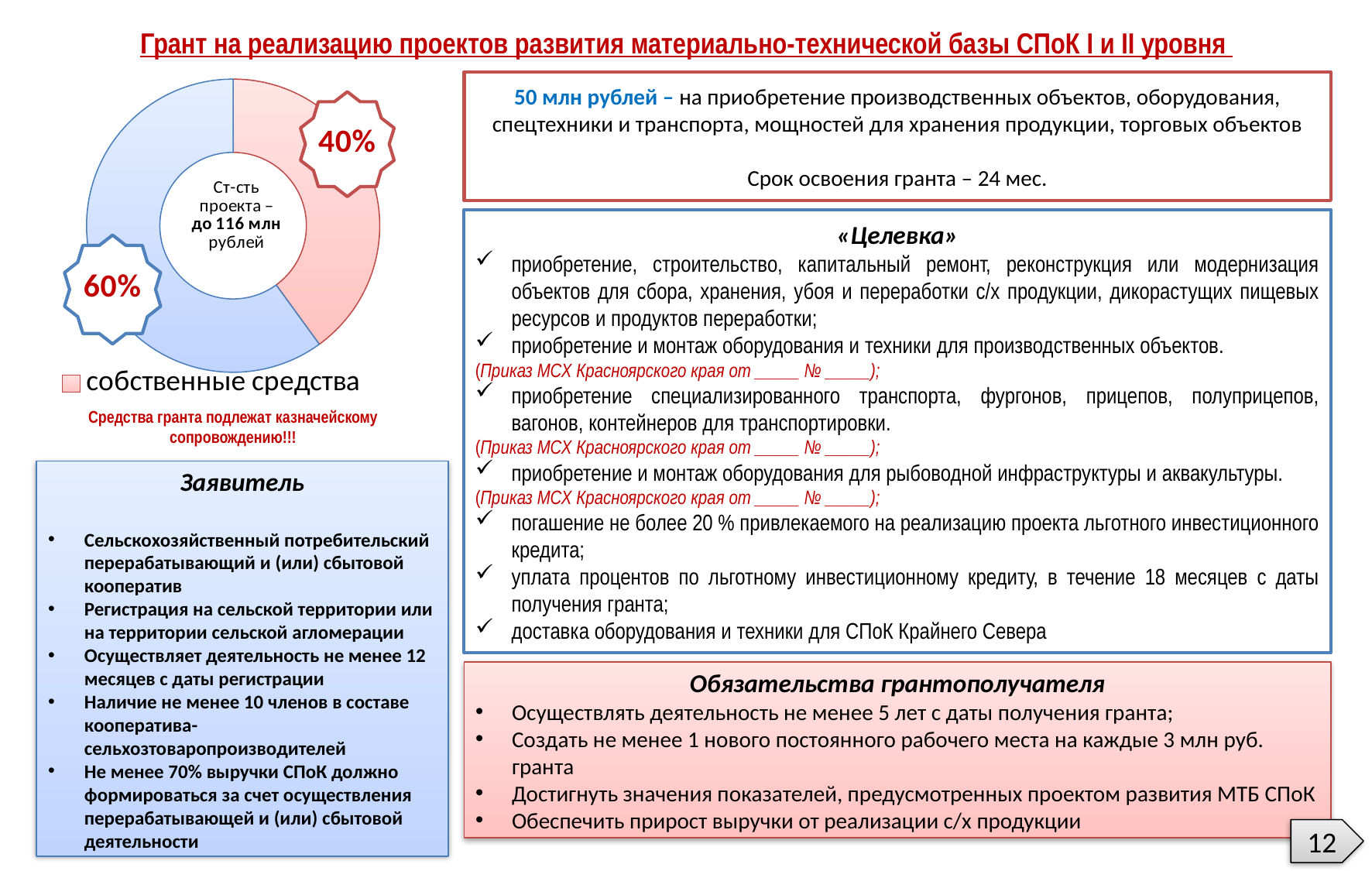
How many slices does the pie chart have? 2 What is the difference in percentage points between the two slices of the pie chart? 20 percentage points What share of the pie chart is labelled «собственные средства»? 40% What percentage is shown on the pink slice of the pie chart? 40% Which slice of the pie chart is larger, the blue one or the pink one? The blue one (60%) What colour is the slice labelled «собственные средства» in the legend? Pink (red) What project cost is written in the centre of the pie chart? до 116 млн рублей What is the largest value shown on the pie chart? 60% What percentage is shown on the blue slice of the pie chart? 60% What kind of chart is shown on the left of the slide? Pie chart (donut) How many entries does the legend of the pie chart list? 1 What is the smallest value shown on the pie chart? 40%